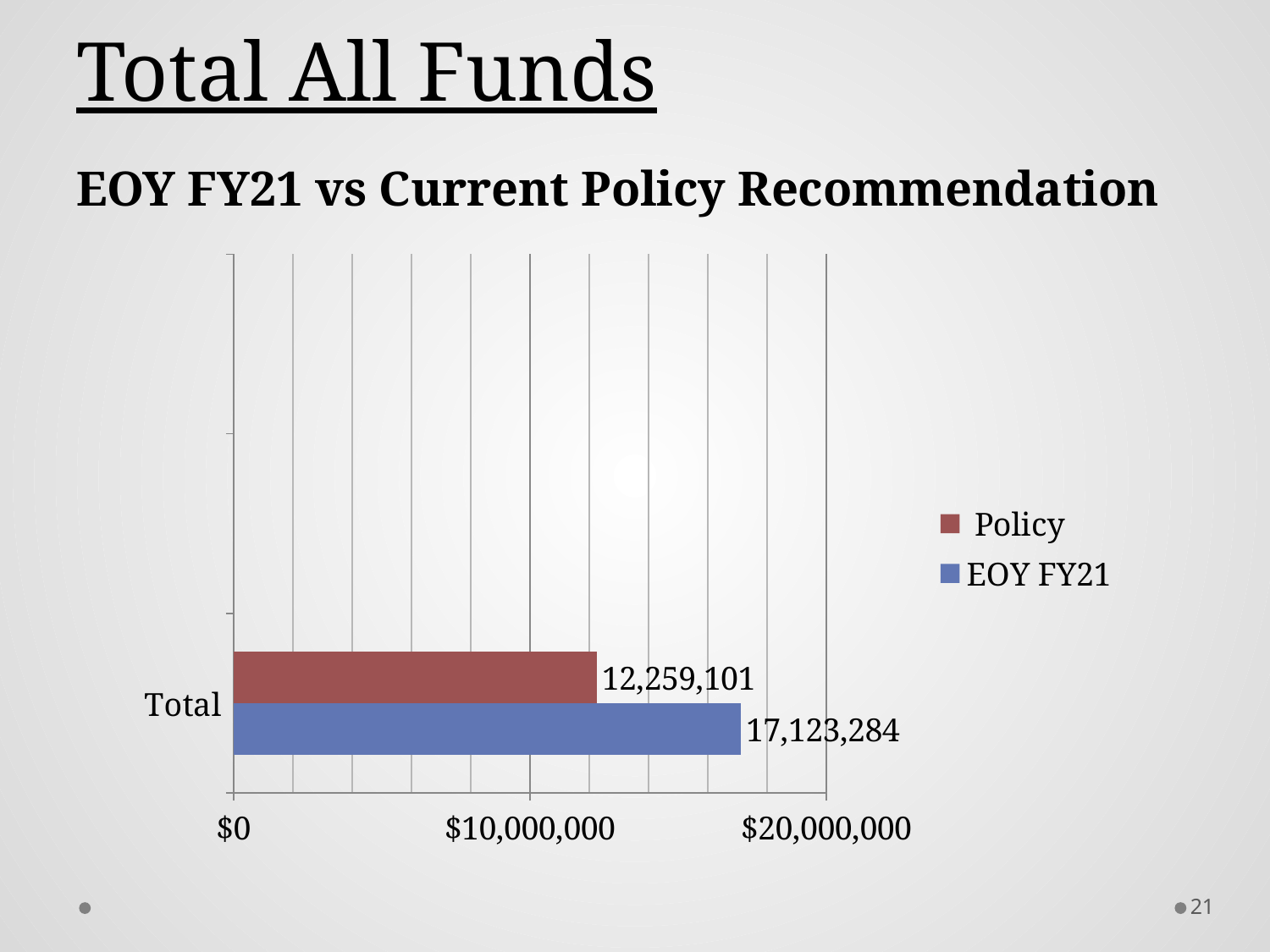
What is the difference between the EOY FY21 value and the Policy value for Total? 4,864,183 How many categories are shown on the vertical axis? 1 What is the label of the single category on the vertical axis? Total What is the value of the EOY FY21 bar for Total? 17,123,284 Is the EOY FY21 value for Total greater or less than $20,000,000? less Is the Policy value for Total greater or less than $10,000,000? greater Which series is shown in blue in the legend? EOY FY21 Which series has the larger value for Total, Policy or EOY FY21? EOY FY21 How many series does the legend list? 2 What is the value of the Policy bar for Total? 12,259,101 What kind of chart is shown on the slide? Bar chart What is the subtitle above the chart? EOY FY21 vs Current Policy Recommendation